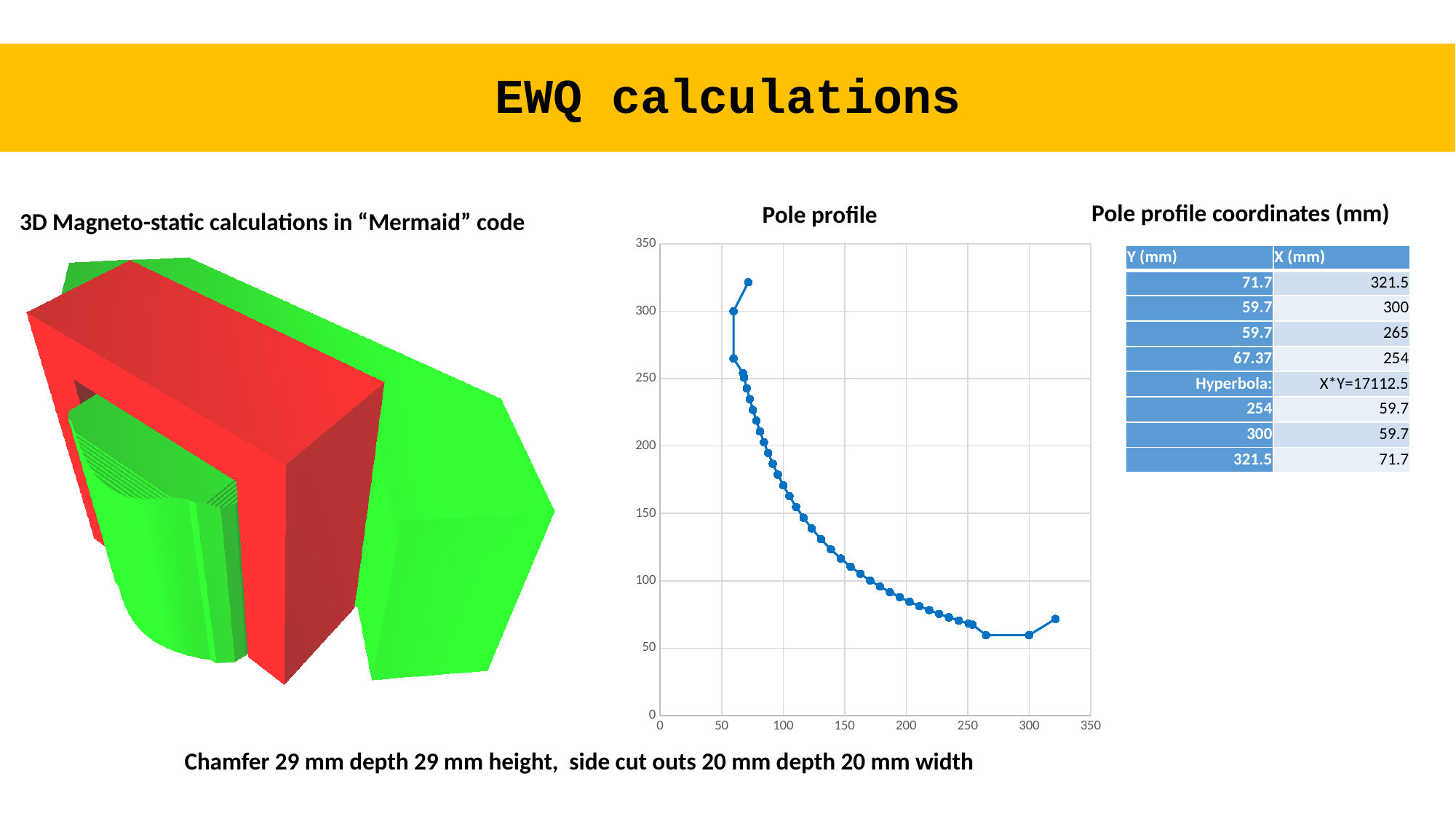
In the "Pole profile" chart, is the y value of the point at x = 150 greater or less than 100? greater In the "Pole profile" chart, is the y value of the point at x = 200 greater or less than 100? less According to the "Pole profile coordinates (mm)" table, what is the X value for Y = 67.37? 254 What is the maximum value shown on the x axis of the "Pole profile" chart? 350 According to the "Pole profile coordinates (mm)" table, what is the smallest Y value listed? 59.7 What kind of chart is the "Pole profile" chart? scatter chart In the "Pole profile" chart, is the y value of the lowest points greater or less than 50? greater In the "Pole profile" chart, do the y values generally rise or fall as x increases from 60 to 260? fall What is the title of the chart on the slide? Pole profile According to the "Pole profile coordinates (mm)" table, what is the largest X value listed? 321.5